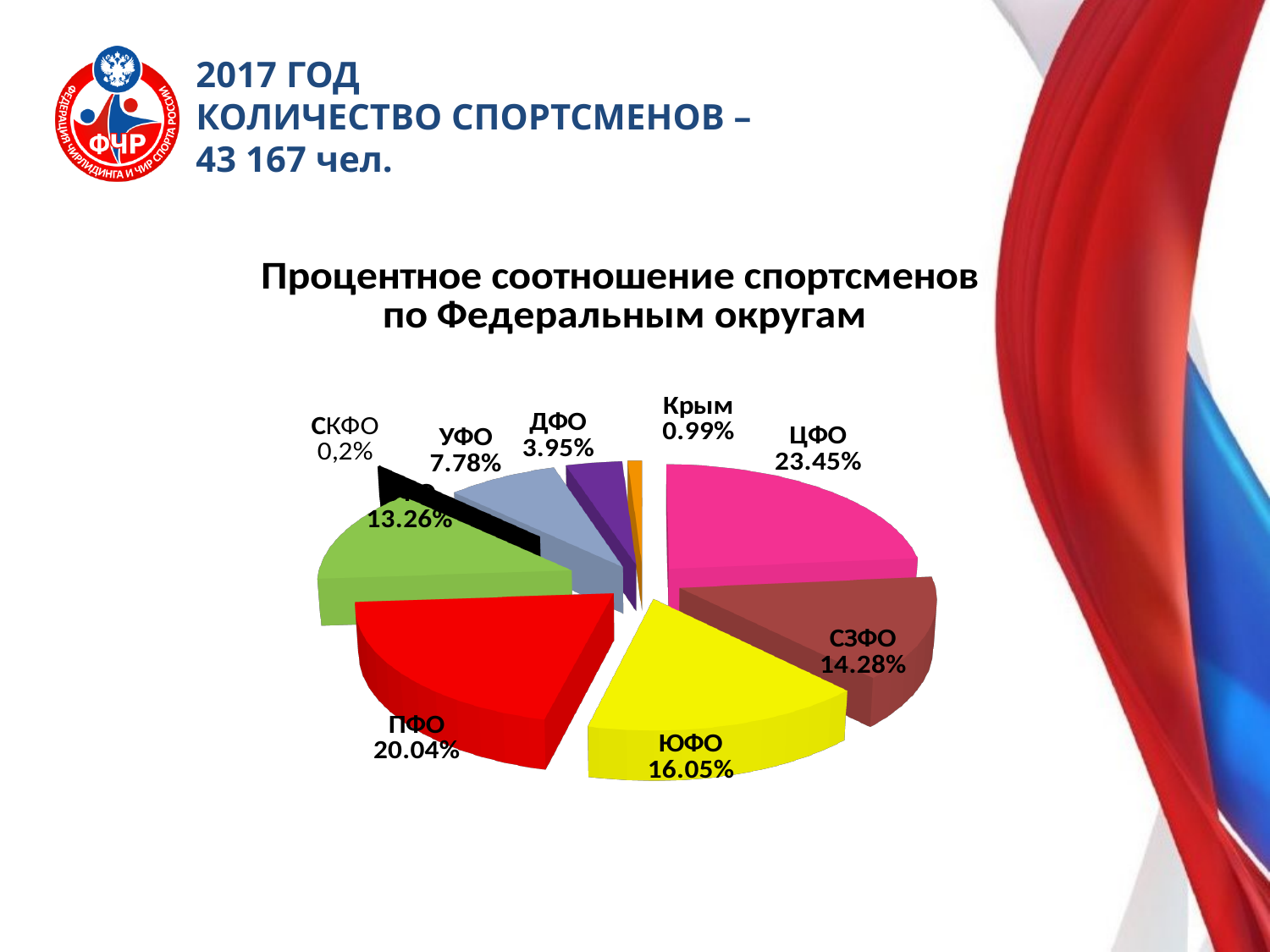
What is the title of the chart? Процентное соотношение спортсменов по Федеральным округам What percentage of athletes is shown for ЦФО? 23.45% What percentage of athletes is shown for ЮФО? 16.05% What is the difference in percentage points between ЦФО and ПФО? 3.41 Which federal district has the smallest share of athletes? СКФО What percentage of athletes is shown for ДФО? 3.95% What percentage of athletes is shown for Крым? 0.99% What colour is the slice for ЮФО? yellow Which federal district has the largest share of athletes? ЦФО What type of chart is shown on the slide? pie chart Which has a larger share of athletes, ПФО or СЗФО? ПФО How many slices does the pie chart have? 9